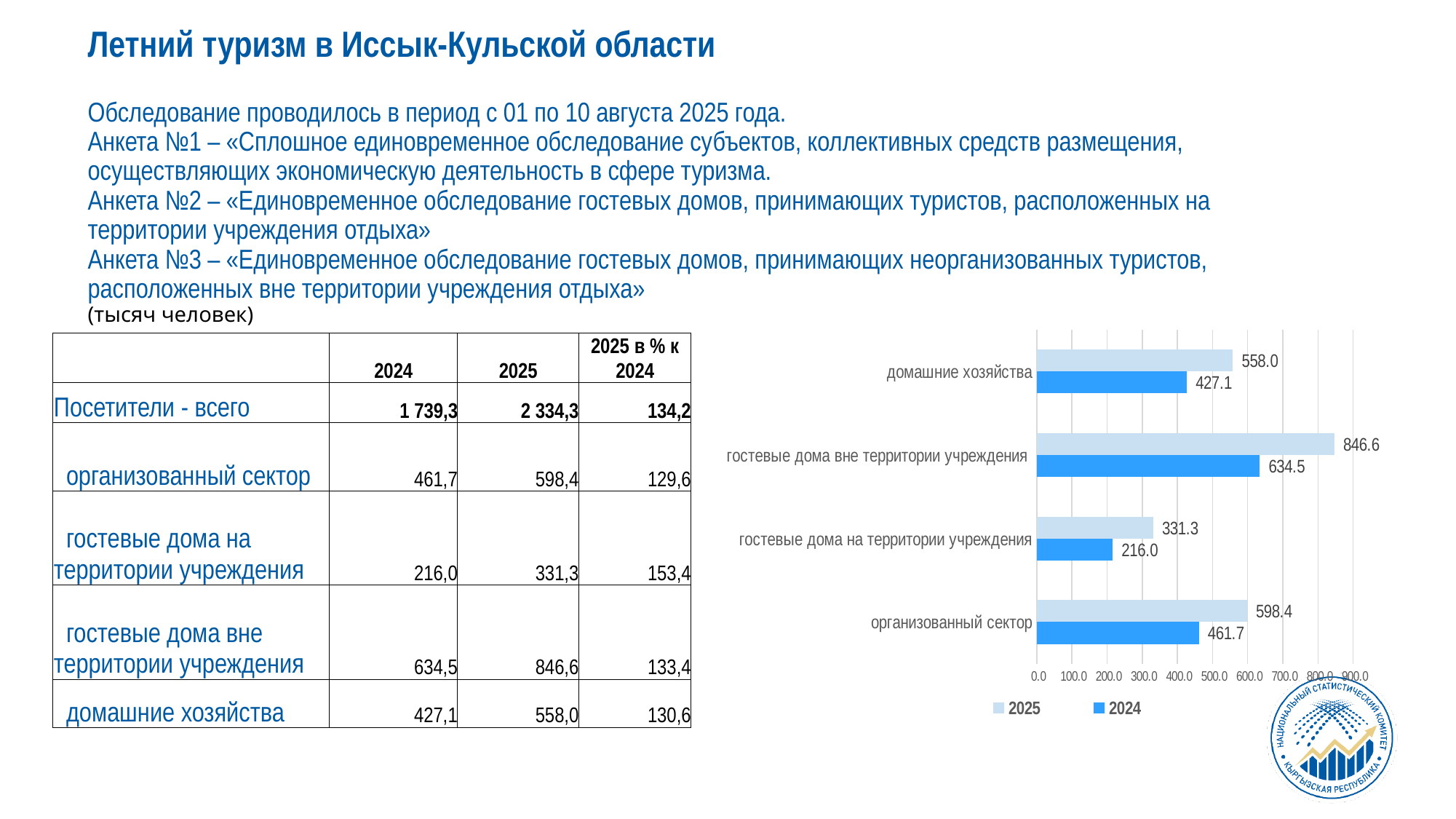
Is the 2024 value for домашние хозяйства in the bar chart greater or less than 400.0? greater How many categories are shown in the bar chart? 4 What type of chart is shown on the slide? bar chart How many series does the legend of the bar chart list? 2 What is the 2024 value for гостевые дома вне территории учреждения in the bar chart? 634.5 In the bar chart, what is the difference between the 2025 and 2024 values for гостевые дома на территории учреждения? 115.3 Which category has the highest 2025 value in the bar chart? гостевые дома вне территории учреждения Which category has the lowest 2024 value in the bar chart? гостевые дома на территории учреждения What is the 2025 value for домашние хозяйства in the bar chart? 558.0 In the bar chart, which has the larger 2025 value: домашние хозяйства or организованный сектор? организованный сектор In the bar chart, how much larger is the 2025 value than the 2024 value for организованный сектор? 136.7 What are the legend entries of the bar chart? 2025 and 2024